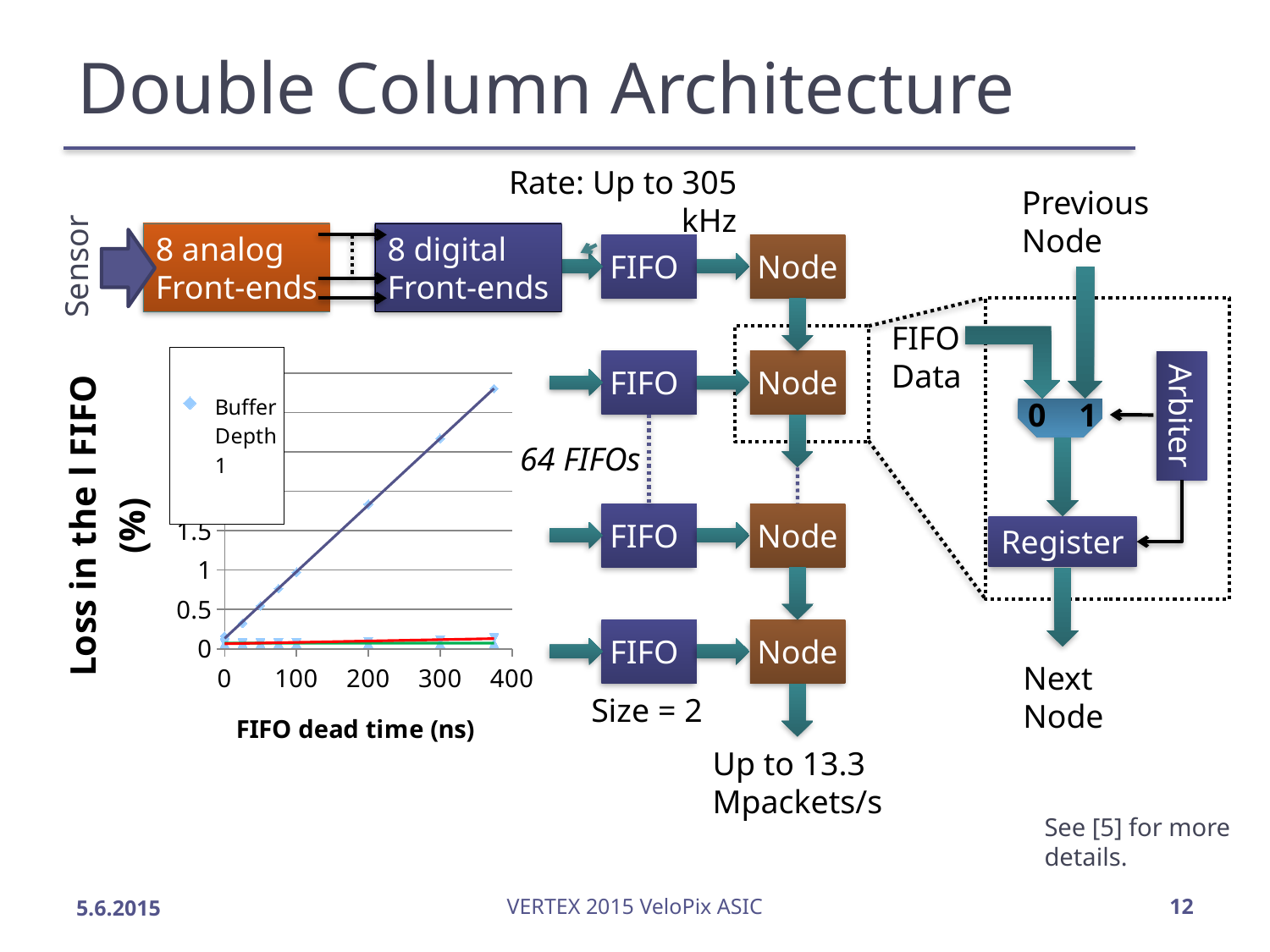
At 300 ns FIFO dead time, which is larger: the Buffer Depth 1 series or the red series? Buffer Depth 1 Is the Buffer Depth 1 value at 0 ns FIFO dead time greater or less than 0.5? less What is the label of the y axis of the chart? Loss in the I FIFO (%) How many tick labels are shown on the x axis of the chart? 5 Is the Buffer Depth 1 value at 200 ns FIFO dead time greater or less than 1.5? greater What is the highest value shown on the x axis of the chart? 400 What kind of chart is shown on the slide? scatter chart with lines What is the label of the x axis of the chart? FIFO dead time (ns) Does the Buffer Depth 1 series rise or fall as FIFO dead time increases? rise Is the Buffer Depth 1 value at 300 ns FIFO dead time greater or less than 1.5? greater